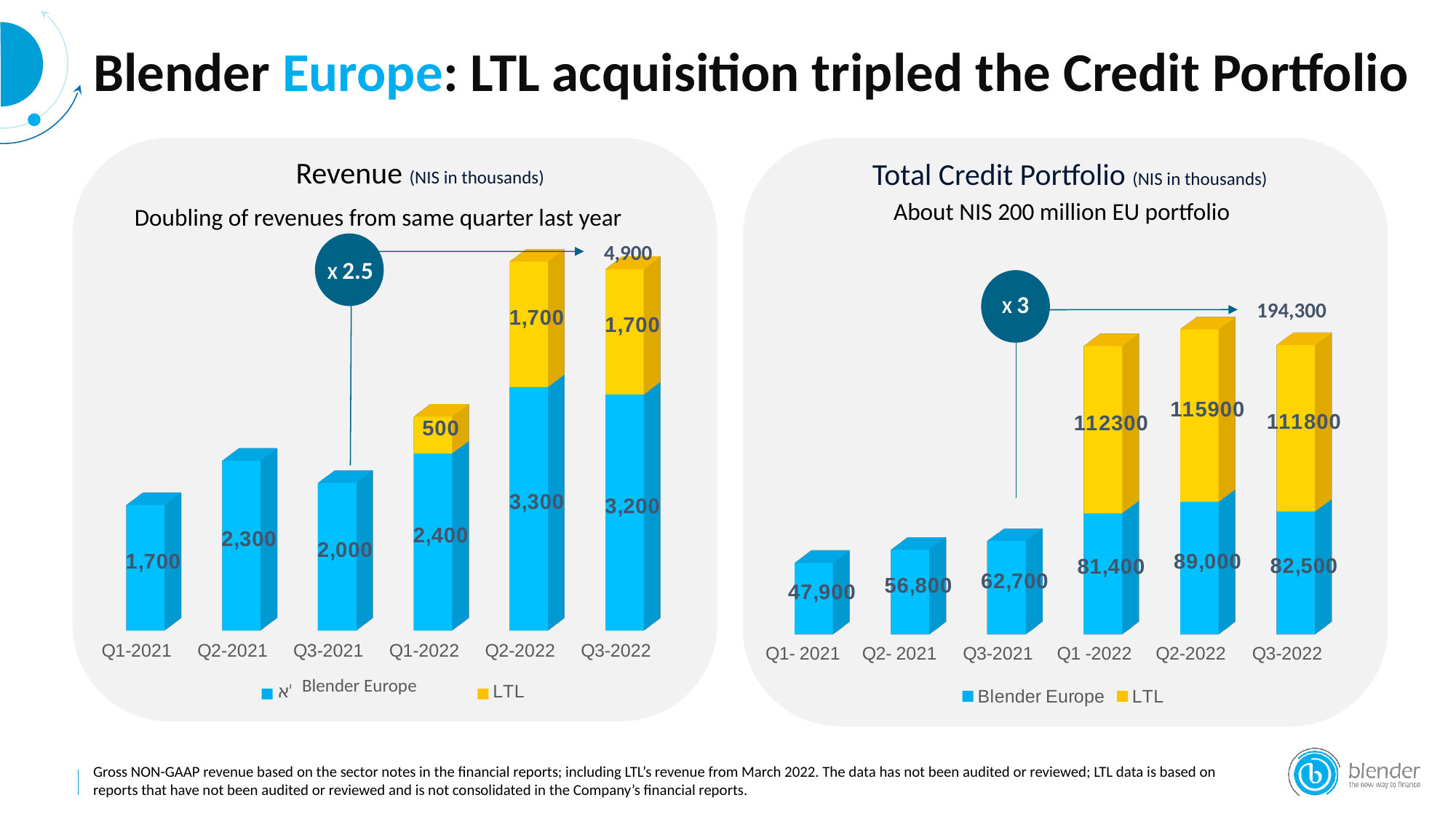
In the Total Credit Portfolio chart, which quarter has the highest Blender Europe value? Q2-2022 What kind of chart is the Total Credit Portfolio chart? Stacked bar chart In the Revenue chart, what is the LTL value for Q1-2022? 500 How many series does the legend of the Revenue chart list? 2 In the Revenue chart, which quarter has the lowest Blender Europe value? Q1-2021 In the Total Credit Portfolio chart, what is the LTL value for Q2-2022? 115900 In the Total Credit Portfolio chart, what is the Blender Europe value for Q3-2021? 62,700 In the Revenue chart, what is the Blender Europe value for Q2-2022? 3,300 In the Total Credit Portfolio chart, what is the total of the stacked bar for Q3-2022? 194,300 In the Revenue chart, what is the total of the stacked bar for Q3-2022? 4,900 In the Total Credit Portfolio chart, how many quarters are shown on the x axis? 6 In the Revenue chart, what is the difference between the Blender Europe values for Q2-2021 and Q1-2021? 600